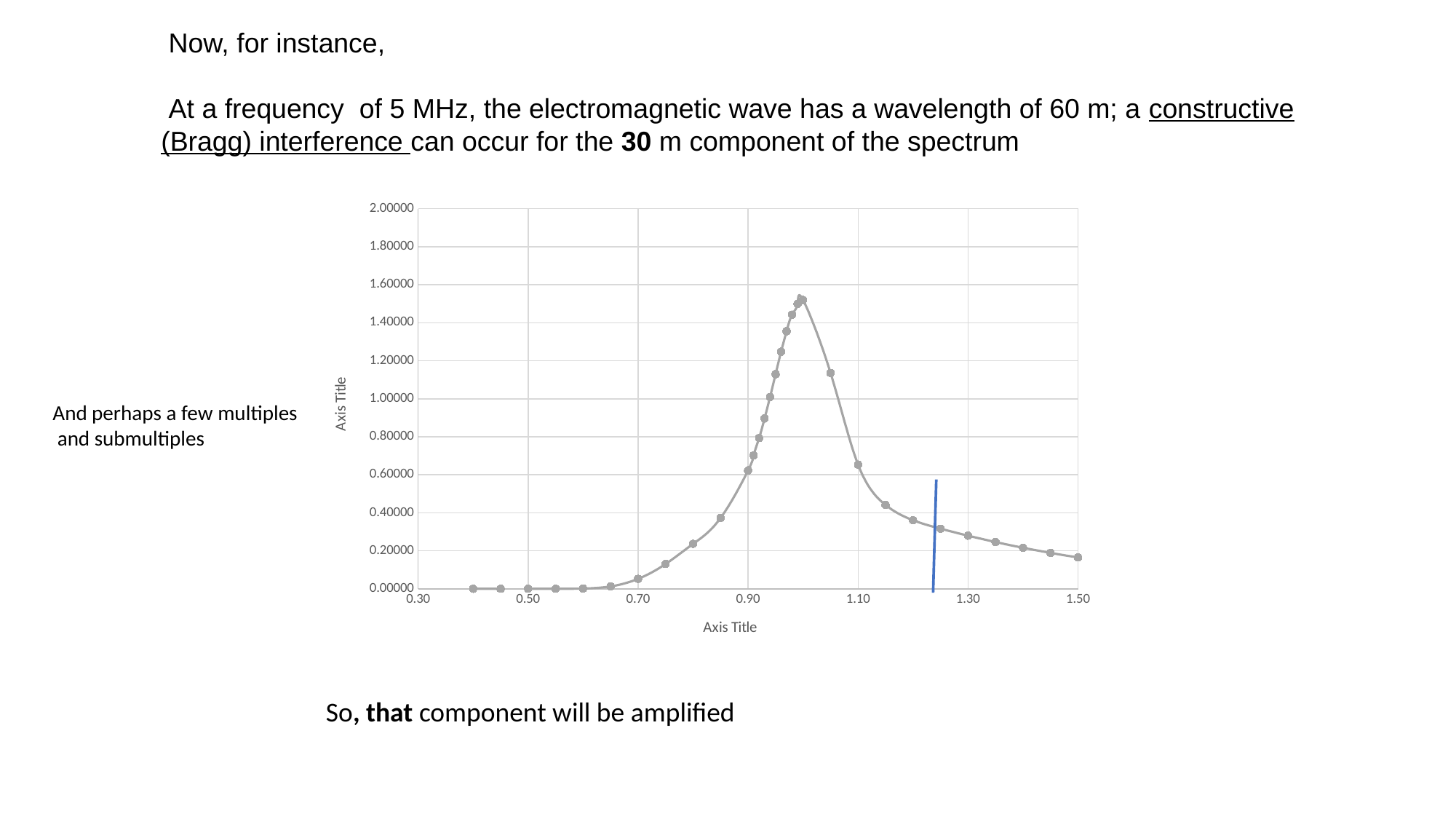
Which is larger, the value at x = 0.90 or the value at x = 1.30? the value at x = 0.90 Is the value of the curve at x = 0.50 greater or less than 0.20? less What kind of chart is shown on the slide? line chart Is the peak value of the curve greater or less than 1.40? greater Is the value of the curve at x = 0.70 greater or less than 0.20? less What text is shown as the horizontal axis title? Axis Title Do the values rise or fall as x increases from 1.10 to 1.50? fall Do the values rise or fall as x increases from 0.70 to 0.90? rise What is the highest tick value shown on the vertical axis? 2.00000